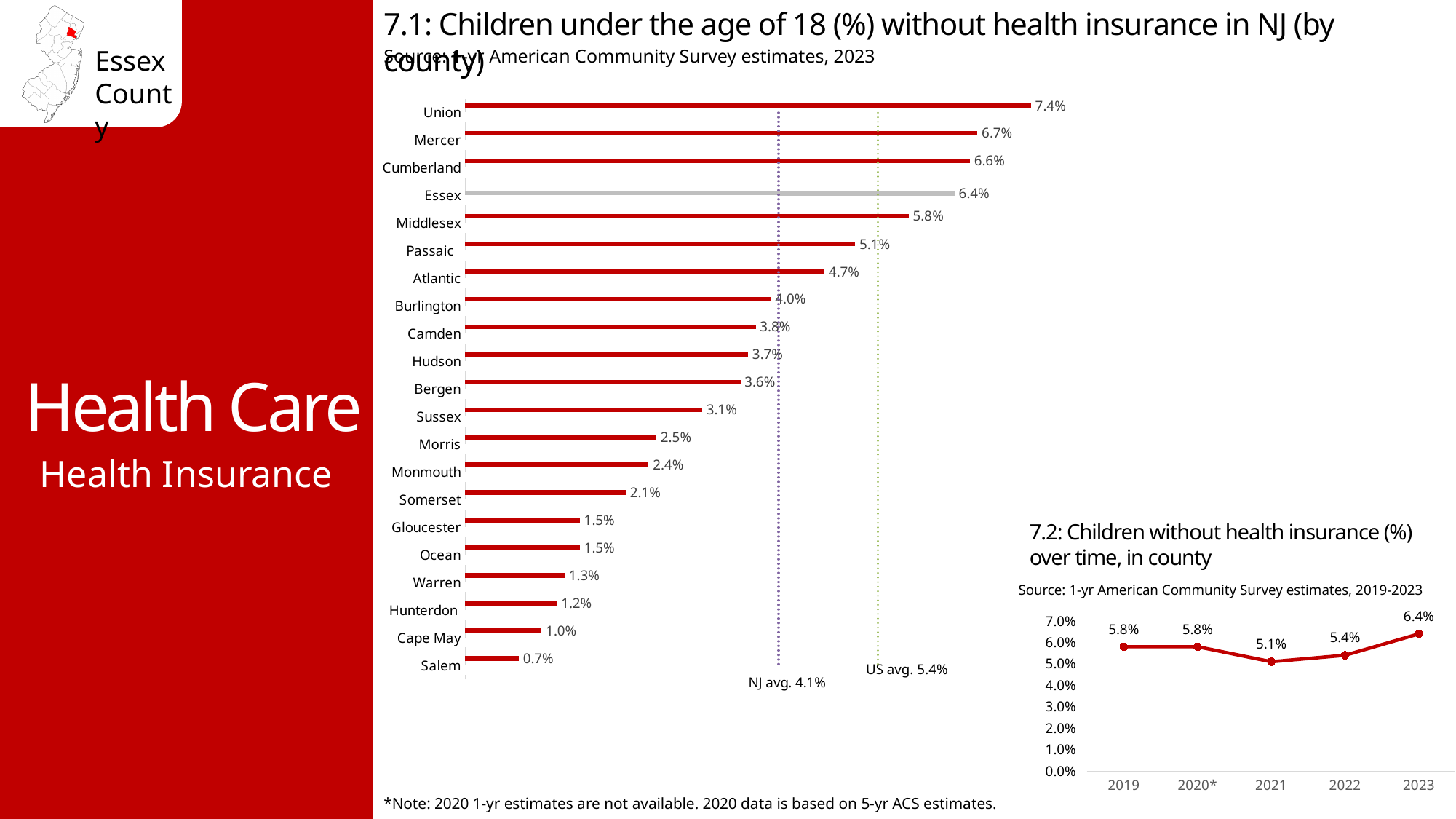
What kind of chart is chart 7.1? Bar chart In chart 7.1, which county has the lowest percentage of children without health insurance? Salem In chart 7.1, what is the NJ average shown by the dotted reference line? 4.1% In chart 7.2, what is the difference between the 2023 and 2022 values? 1.0% What kind of chart is chart 7.2? Line chart In chart 7.1 (children under 18 without health insurance by county), what is the value for Essex? 6.4% In chart 7.1, which county has a larger value, Passaic or Atlantic? Passaic In chart 7.1, which county has the highest percentage of children without health insurance? Union In chart 7.1, how many counties are plotted? 21 In chart 7.2, which year has the highest value? 2023 In chart 7.1, what is the difference between the values for Union and Salem? 6.7% In chart 7.2 (children without health insurance over time), what is the value for 2021? 5.1%